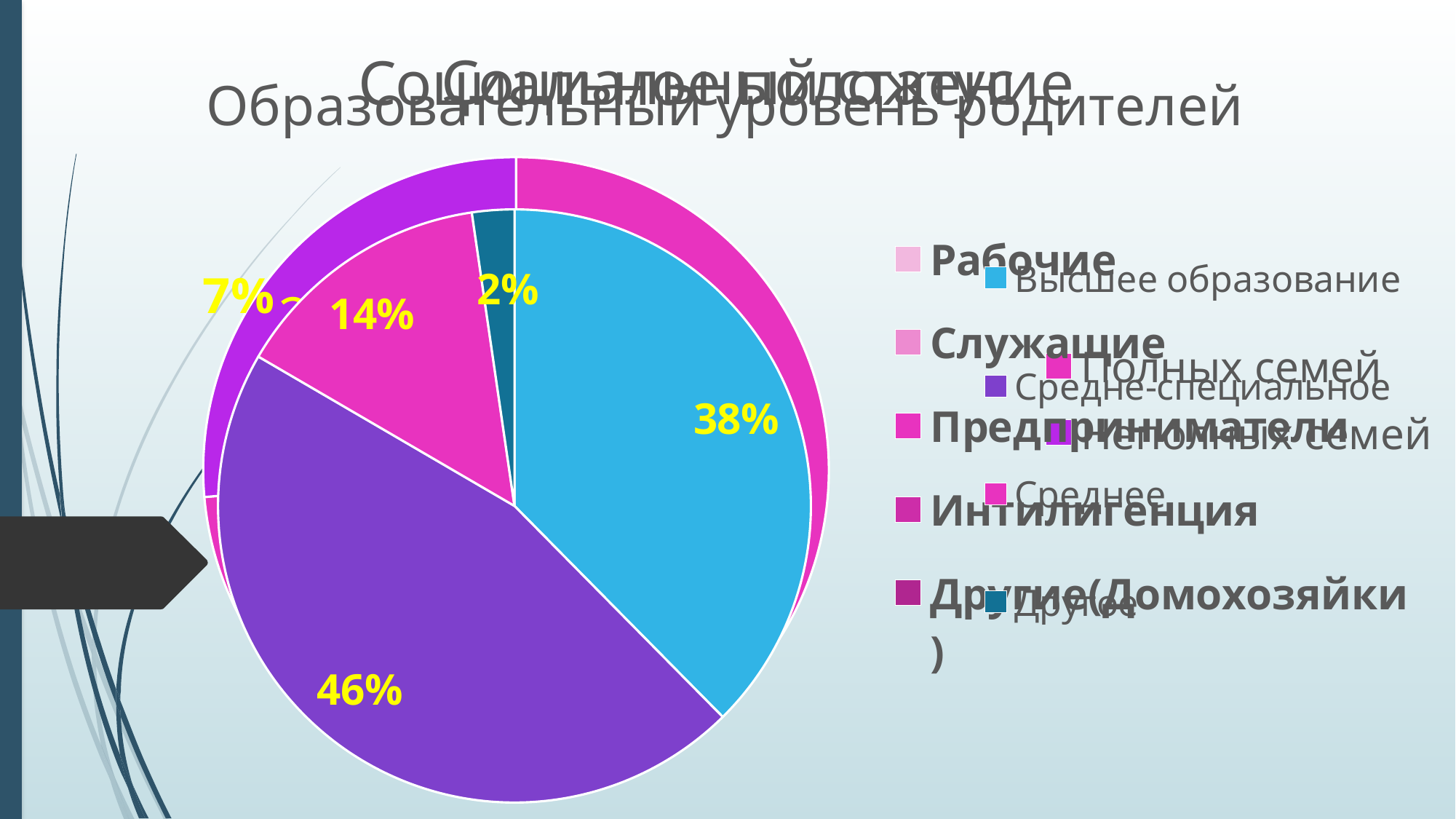
On the pie chart 'Образовательный уровень родителей', what colour is the 'Высшее образование' slice? Blue How many slices does the pie chart 'Образовательный уровень родителей' have? 4 On the pie chart 'Образовательный уровень родителей', what percentage is shown for 'Высшее образование'? 38% On the pie chart 'Образовательный уровень родителей', what percentage is shown for 'Среднее'? 14% On the pie chart 'Образовательный уровень родителей', which category has the largest share? Средне-специальное On the pie chart 'Образовательный уровень родителей', what percentage is shown for 'Средне-специальное'? 46% On the pie chart 'Образовательный уровень родителей', what is the difference in percentage points between 'Средне-специальное' and 'Высшее образование'? 8 On the pie chart 'Образовательный уровень родителей', what percentage is shown for 'Другое'? 2% On the pie chart 'Образовательный уровень родителей', which is larger: 'Среднее' or 'Высшее образование'? Высшее образование What type of chart is used for 'Образовательный уровень родителей'? Pie chart On the pie chart 'Образовательный уровень родителей', which category has the smallest share? Другое On the pie chart 'Образовательный уровень родителей', what is the difference in percentage points between 'Среднее' and 'Другое'? 12